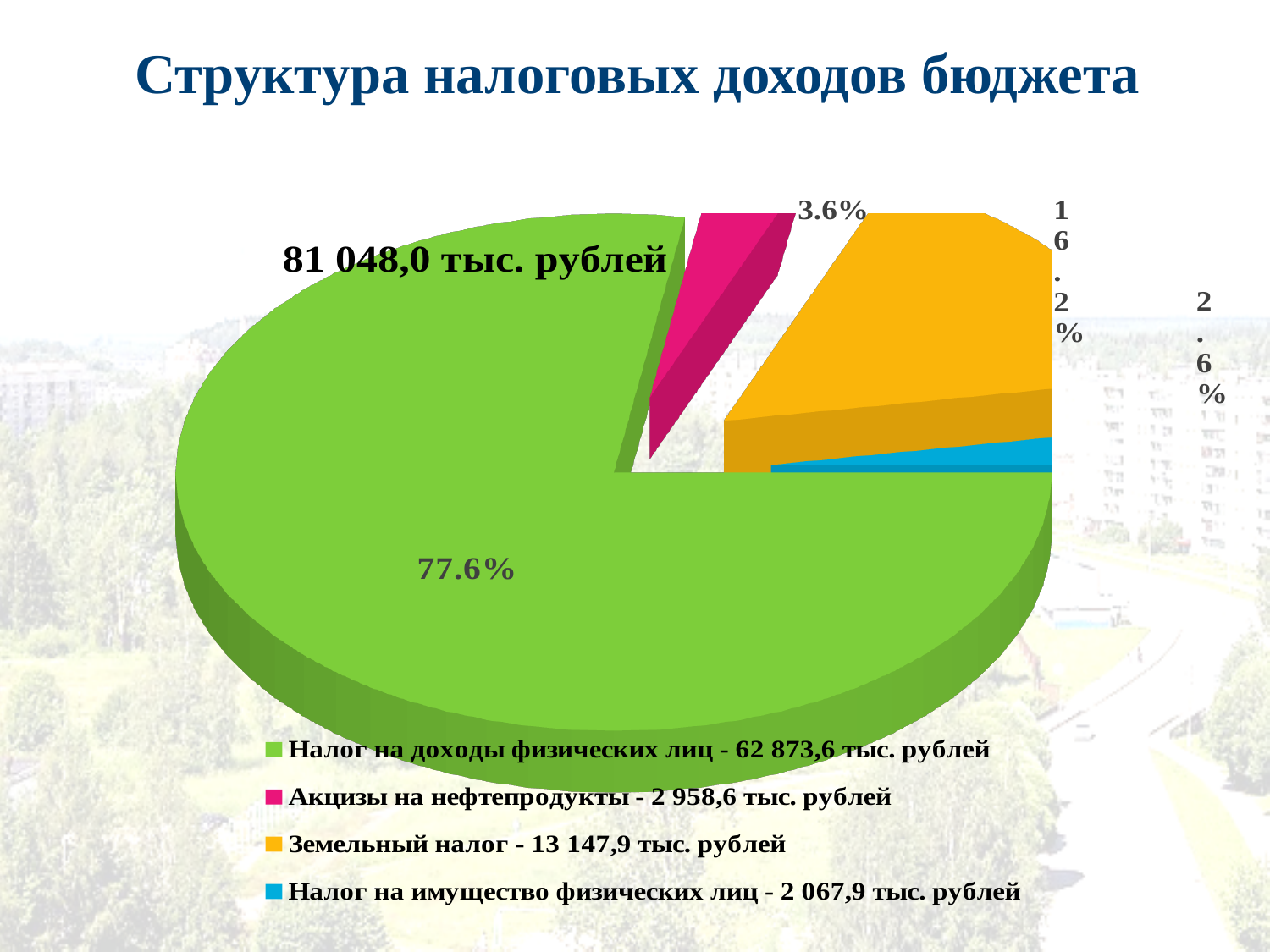
Which category has the largest slice of the pie? Налог на доходы физических лиц How many slices does the pie chart have? 4 How many entries does the legend list? 4 What share of the pie does "Акцизы на нефтепродукты" take? 3.6% What is the value shown in the legend for "Земельный налог"? 13 147,9 тыс. рублей What kind of chart is shown on the slide? Pie chart Which category has the smallest slice of the pie? Налог на имущество физических лиц What share of the pie does "Налог на имущество физических лиц" take? 2.6% What share of the pie does "Земельный налог" take? 16.2% Which is larger: the share for "Акцизы на нефтепродукты" or the share for "Земельный налог"? Земельный налог What is the title of the chart on the slide? 81 048,0 тыс. рублей